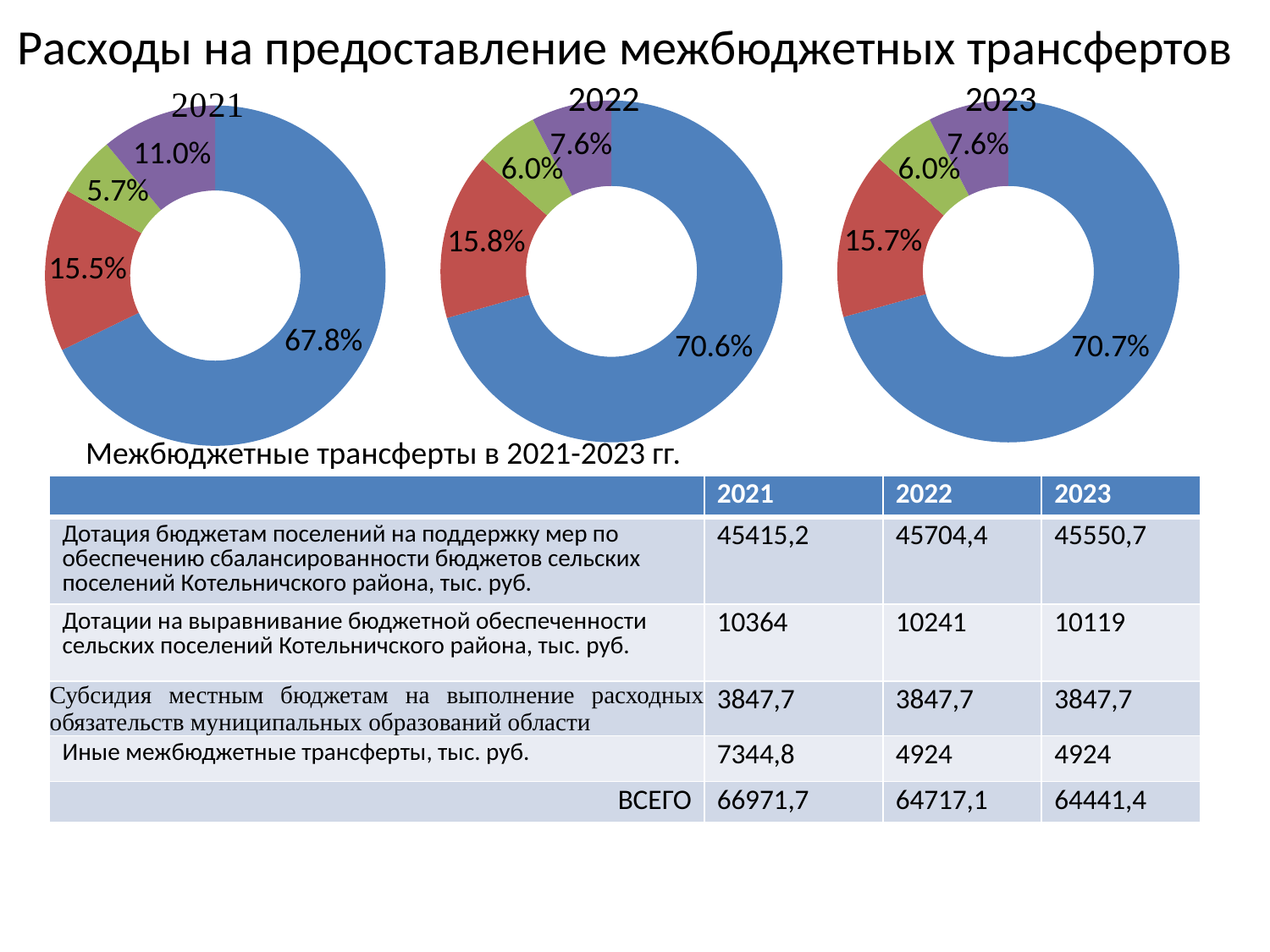
In the chart titled 2021, what percentage is shown on the purple slice? 11.0% Which chart has the larger blue slice, the chart titled 2021 or the chart titled 2022? 2022 In the chart titled 2022, what is the share of the largest slice? 70.6% In the chart titled 2021, what is the difference in percentage points between the largest slice (67.8%) and the red slice (15.5%)? 52.3 percentage points In the chart titled 2022, what is the share of the smallest slice? 6.0% How many slices does the chart titled 2021 have? 4 What kind of chart is the chart titled 2021? doughnut chart In the chart titled 2023, what is the share of the largest slice? 70.7% In the chart titled 2021, what is the share of the smallest slice? 5.7% In the chart titled 2023, what percentage is shown on the red slice? 15.7% In the chart titled 2021, what is the share of the largest slice? 67.8% How many doughnut charts are shown on the slide? 3